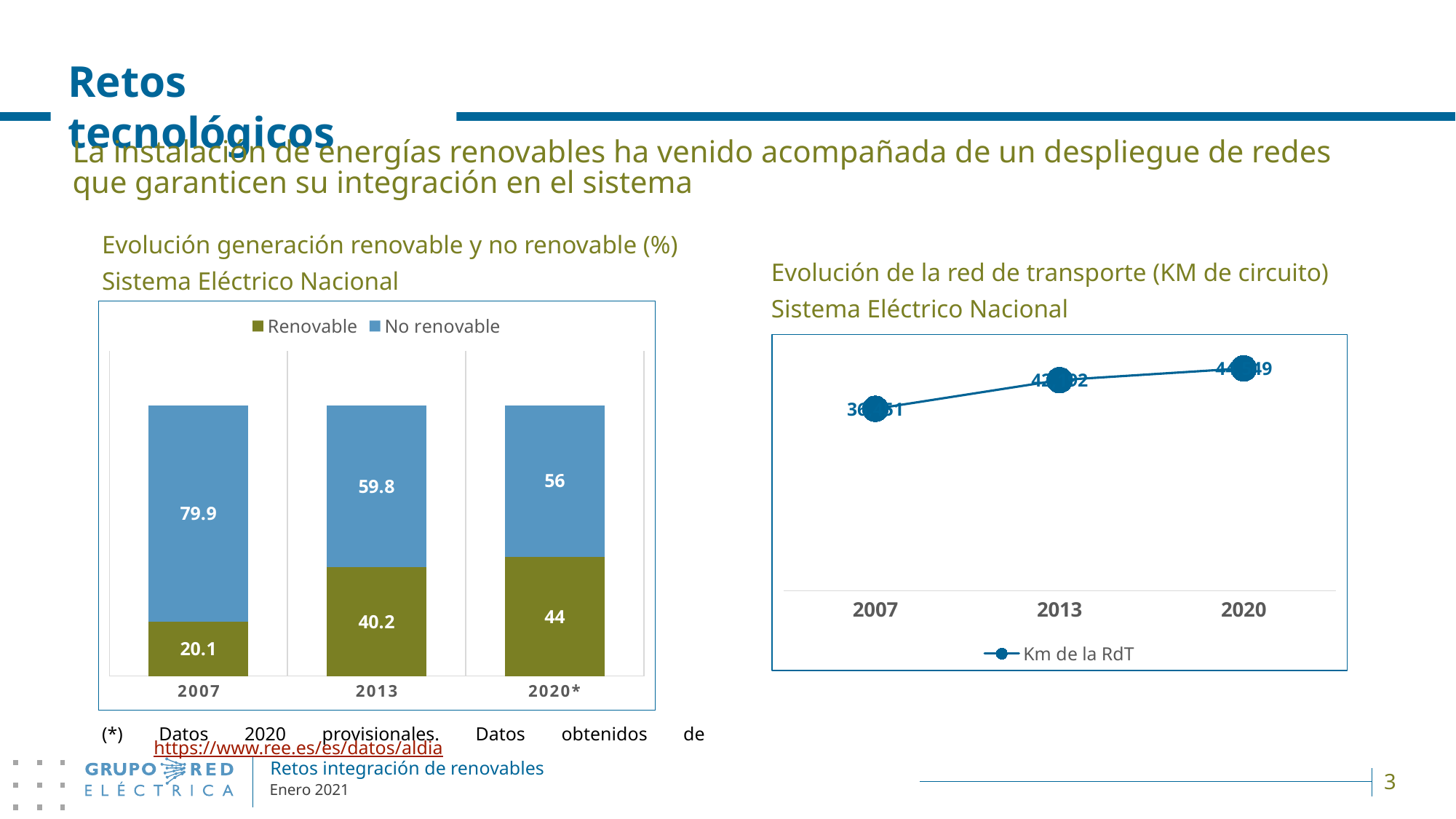
In the chart 'Evolución generación renovable y no renovable (%)', what is the total of the stacked bar for 2020*? 100 In the chart 'Evolución generación renovable y no renovable (%)', what is the difference between the No renovable values for 2007 and 2013? 20.1 In the chart 'Evolución generación renovable y no renovable (%)', what is the Renovable value for 2020*? 44 In the chart 'Evolución generación renovable y no renovable (%)', which year has the lowest No renovable value? 2020* In the chart 'Evolución generación renovable y no renovable (%)', what is the Renovable value for 2007? 20.1 In the chart 'Evolución generación renovable y no renovable (%)', what is the No renovable value for 2013? 59.8 In the chart 'Evolución de la red de transporte (KM de circuito)', how many years are plotted on the x axis? 3 In the chart 'Evolución generación renovable y no renovable (%)', is the Renovable value for 2013 larger or smaller than the No renovable value for 2013? smaller In the chart 'Evolución generación renovable y no renovable (%)', does the Renovable value rise or fall from 2007 to 2020*? rise In the chart 'Evolución de la red de transporte (KM de circuito)', what is the name of the series shown in the legend? Km de la RdT In the chart 'Evolución generación renovable y no renovable (%)', which year has the highest Renovable value? 2020* In the chart 'Evolución generación renovable y no renovable (%)', how many series does the legend list? 2